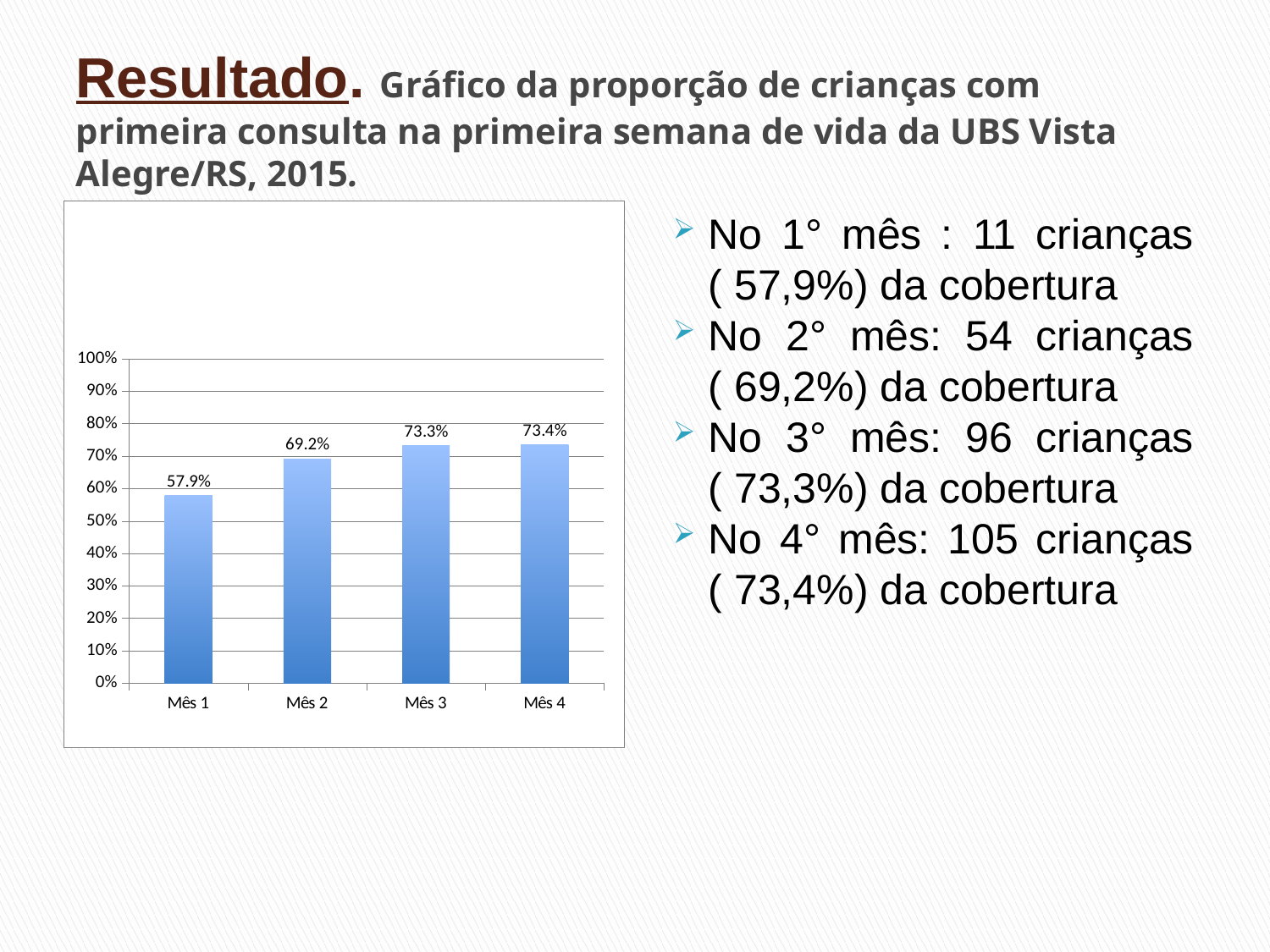
What is the value for Mês 1? 57.9% Which month has the lowest value? Mês 1 Is the value for Mês 3 greater or less than 80%? less Which month has the highest value? Mês 4 What is the difference between the values for Mês 4 and Mês 1? 15.5 percentage points Which is larger, the value for Mês 1 or the value for Mês 2? Mês 2 What is the difference between the values for Mês 2 and Mês 1? 11.3 percentage points How many categories are shown on the x axis? 4 What kind of chart is shown on the slide? bar chart What is the value for Mês 3? 73.3% What is the value for Mês 4? 73.4% What is the value for Mês 2? 69.2%